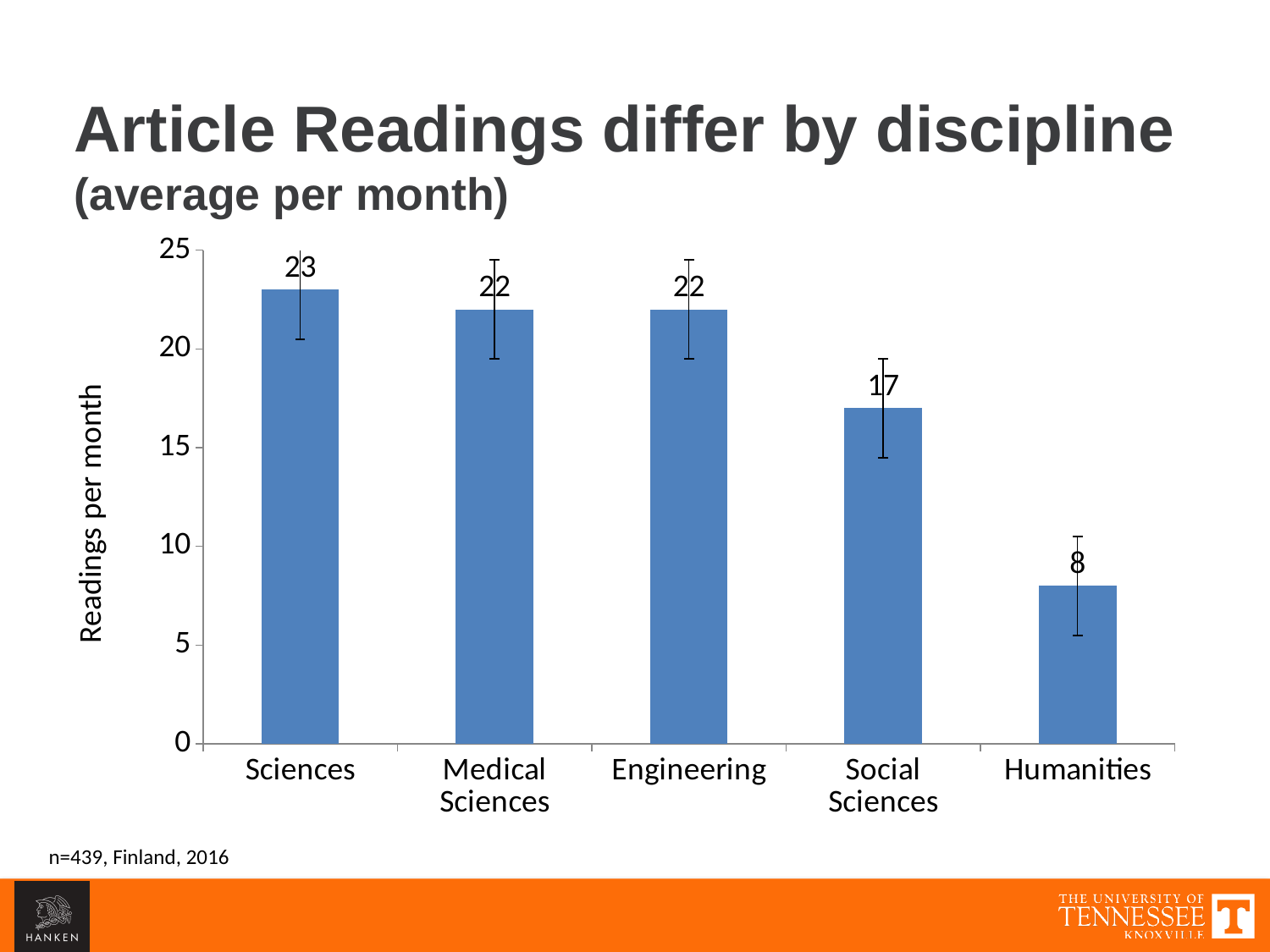
How many disciplines are shown in the chart? 5 What is the average number of article readings per month for Humanities? 8 What is the difference in readings per month between Sciences and Humanities? 15 What is the average number of article readings per month for Engineering? 22 Which has more readings per month, Social Sciences or Humanities? Social Sciences What is the average number of article readings per month for Social Sciences? 17 What type of chart is shown on the slide? Bar chart Which discipline has the lowest average readings per month? Humanities What is the average number of article readings per month for Sciences? 23 What is the label of the vertical axis? Readings per month What is the difference in readings per month between Medical Sciences and Social Sciences? 5 Which discipline has the highest average readings per month? Sciences